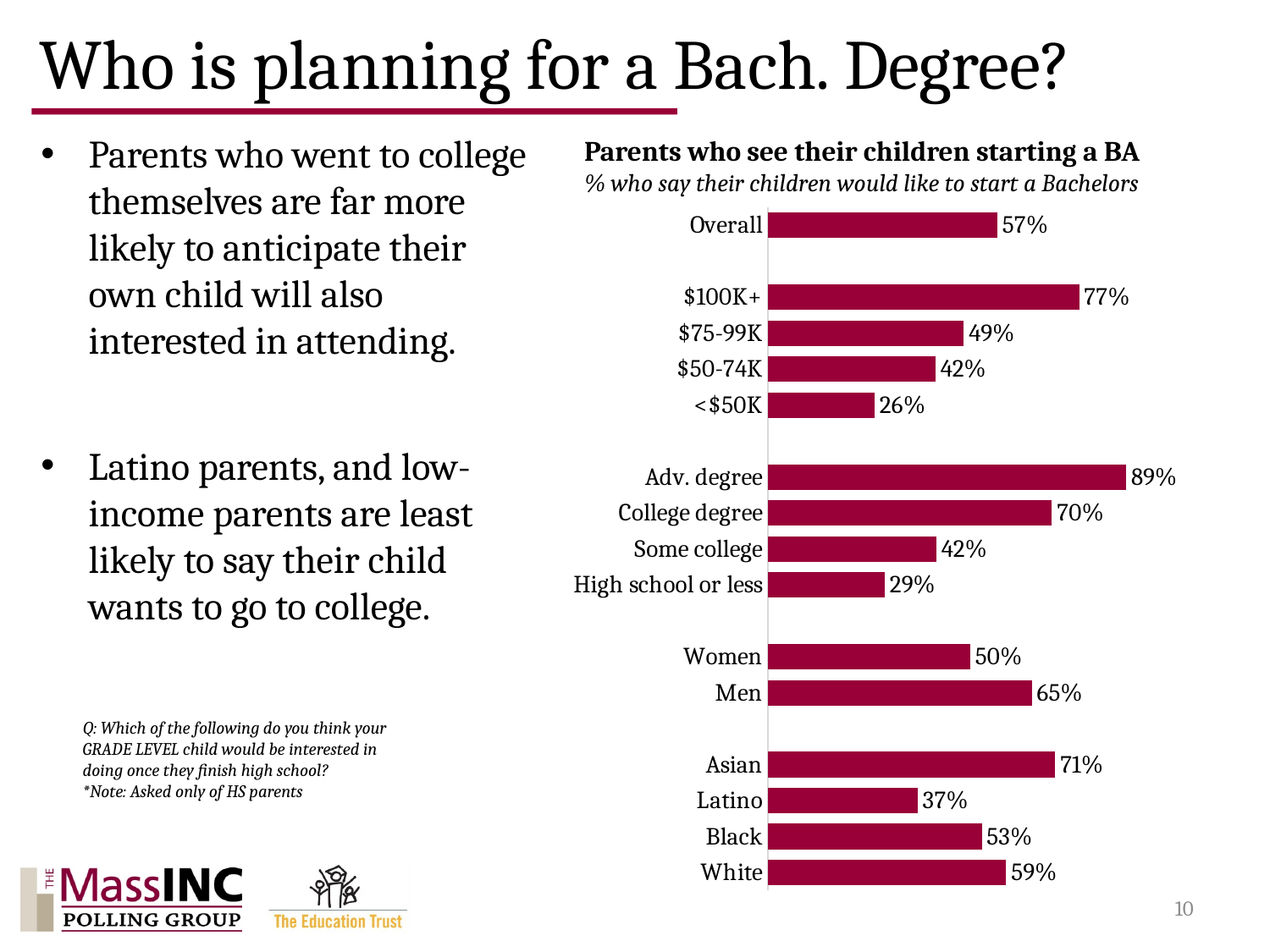
What is the difference between the values for Men and Women? 15 percentage points What type of chart is shown on the slide? Bar chart What percentage of parents with an advanced degree say their children would like to start a Bachelors? 89% Which category has the lowest value in the chart? <$50K How many categories (bars) are shown in the chart? 15 What is the title of the chart? Parents who see their children starting a BA Which category has the highest value in the chart? Adv. degree What is the value for Latino parents? 37% Which is larger, the value for College degree or the value for Some college? College degree Which is larger, the value for Asian or the value for White? Asian What is the value for Overall? 57% What is the difference between the values for $100K+ and <$50K? 51 percentage points